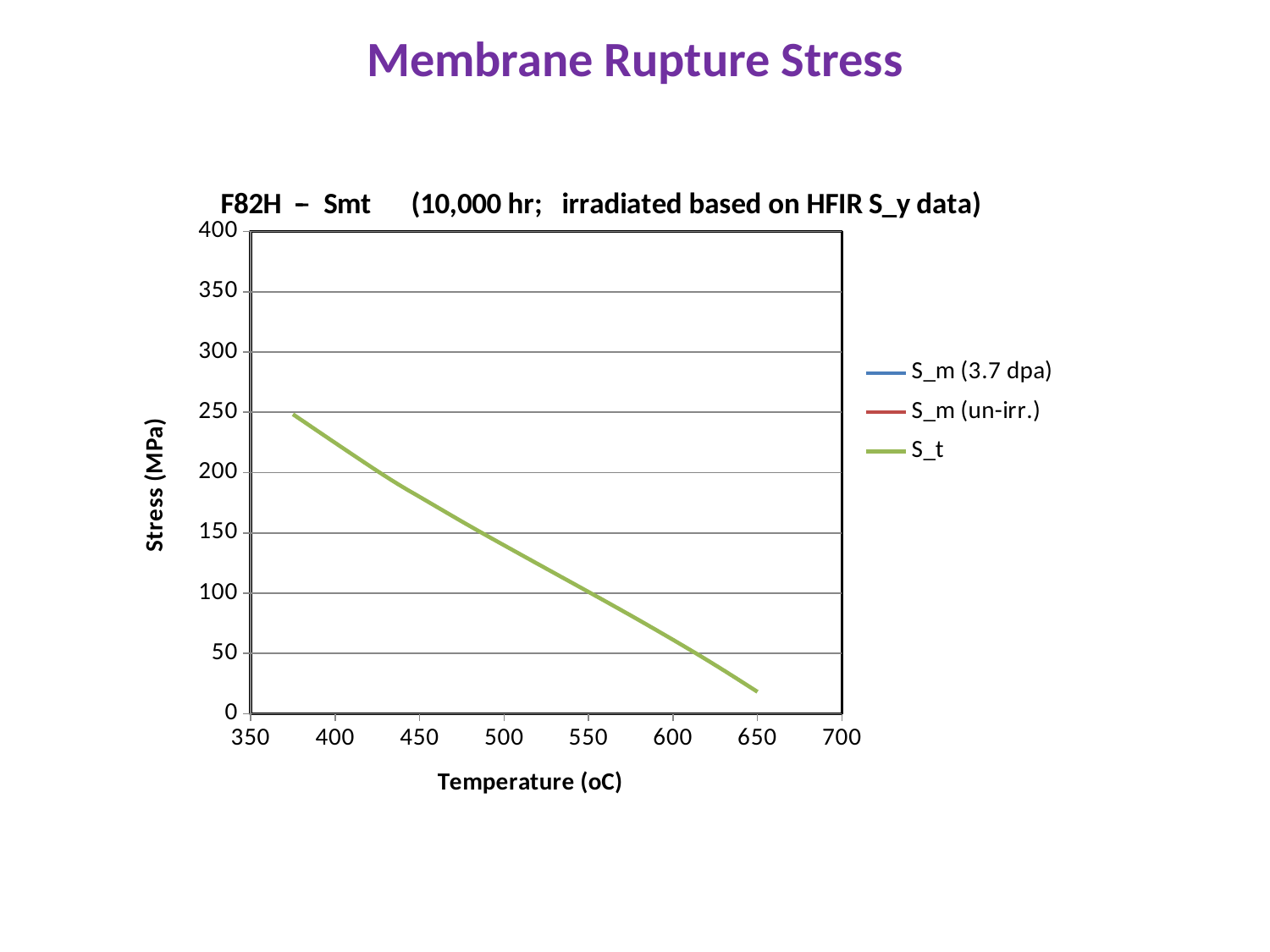
Does the S_t line rise or fall as temperature increases along the x axis? fall How many series does the legend list? 3 Is the S_t value at 650 °C greater or less than 50 MPa? less What kind of chart is shown on the slide? line chart Is the S_t value at 375 °C greater or less than 200 MPa? greater Is the S_t value at 450 °C greater or less than 200 MPa? less What is the label of the y axis? Stress (MPa) Which legend entry is drawn in green? S_t